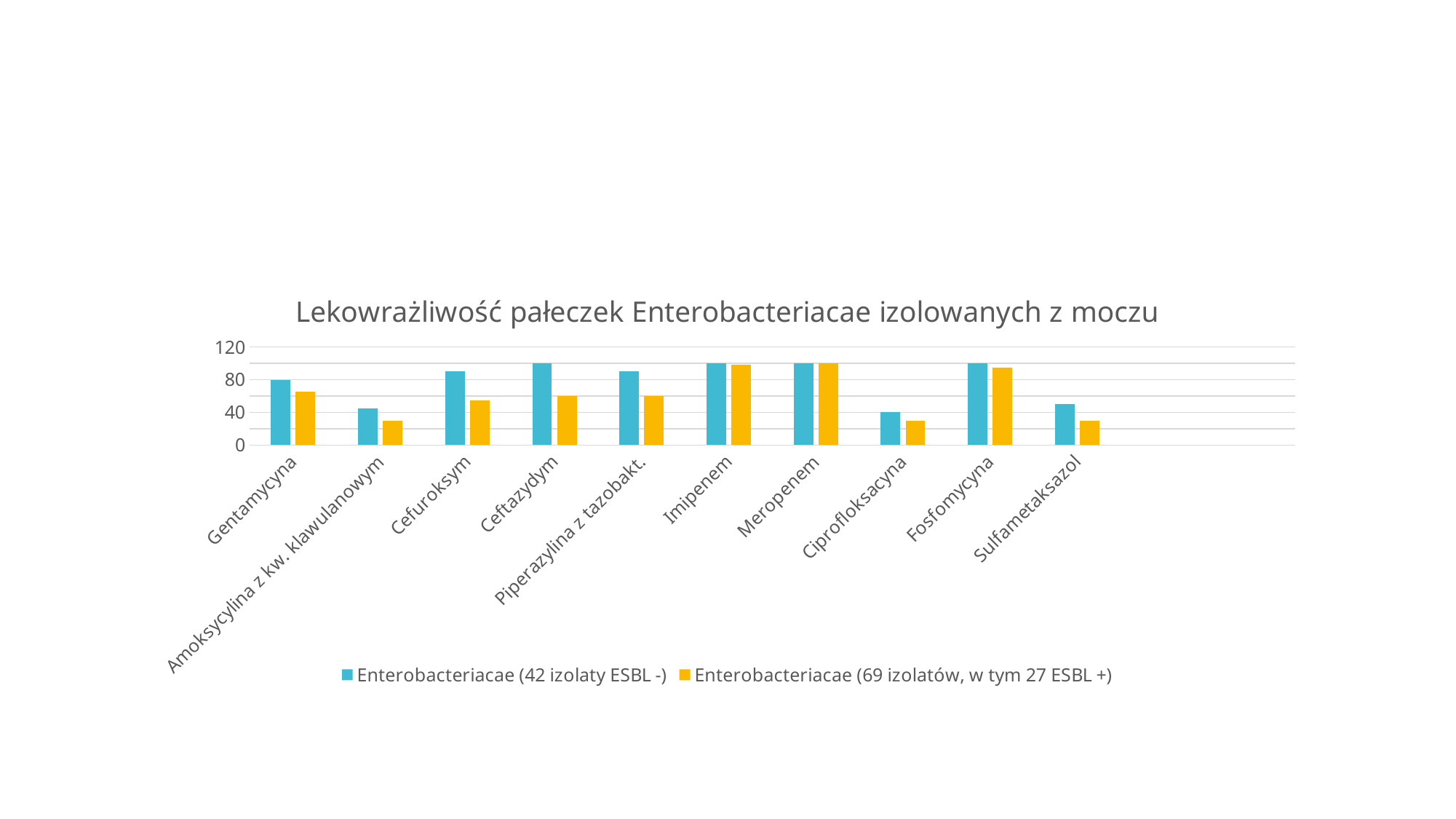
How many antibiotic categories are shown on the x axis? 10 Is the value for Ciprofloksacyna in the Enterobacteriacae (42 izolaty ESBL -) series greater or less than 80? less Is the value for Sulfametaksazol in the Enterobacteriacae (69 izolatów, w tym 27 ESBL +) series greater or less than 40? less What is the title of the chart? Lekowrażliwość pałeczek Enterobacteriacae izolowanych z moczu How many series does the legend list? 2 For Gentamycyna, which series has the larger value: Enterobacteriacae (42 izolaty ESBL -) or Enterobacteriacae (69 izolatów, w tym 27 ESBL +)? Enterobacteriacae (42 izolaty ESBL -) In the Enterobacteriacae (42 izolaty ESBL -) series, which has the larger value: Cefuroksym or Ciprofloksacyna? Cefuroksym Is the value for Amoksycylina z kw. klawulanowym in the Enterobacteriacae (69 izolatów, w tym 27 ESBL +) series greater or less than 40? less What type of chart is shown on the slide? bar chart Which series is shown in yellow? Enterobacteriacae (69 izolatów, w tym 27 ESBL +)